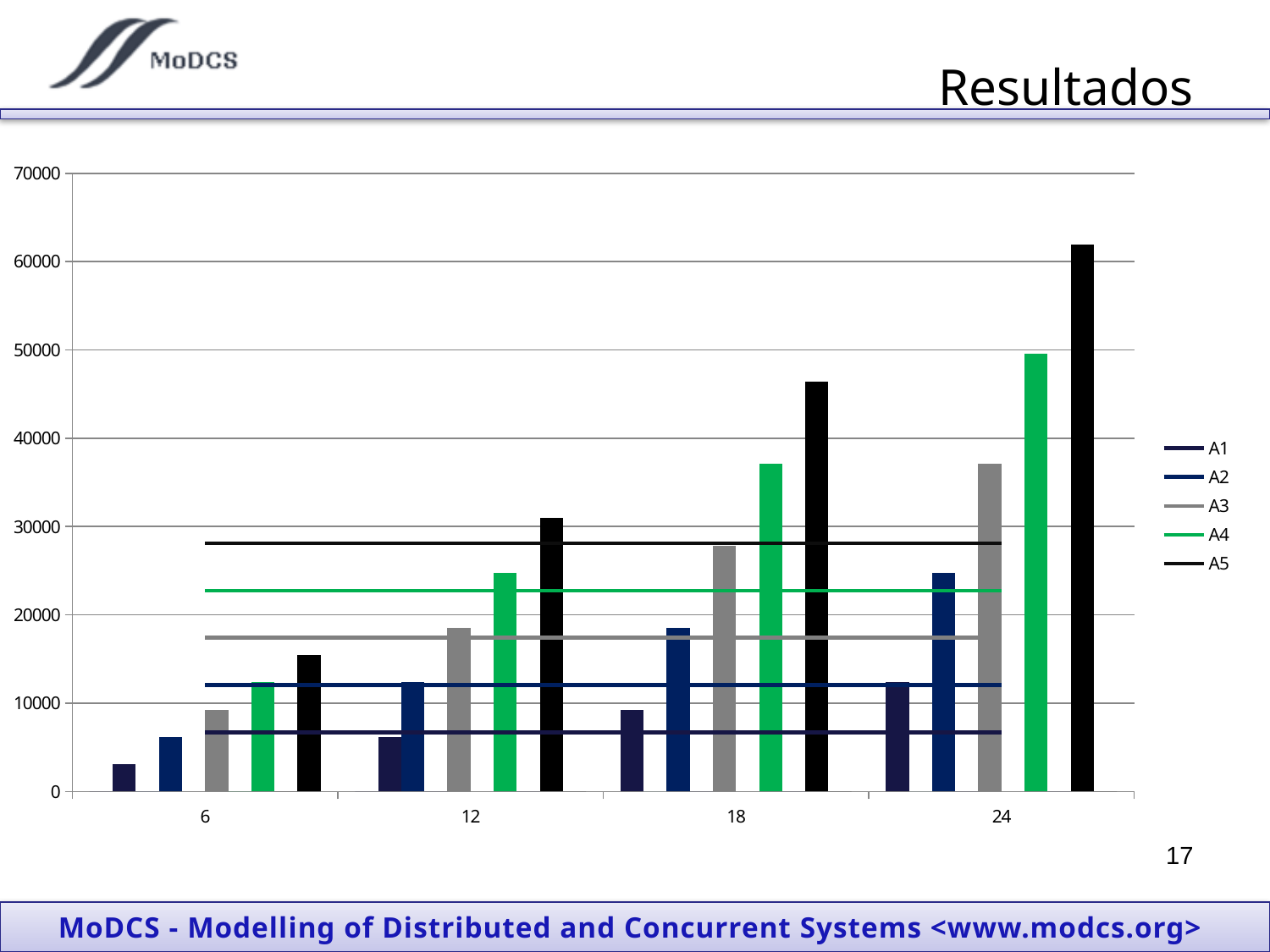
Is the value for A5 at category 24 greater or less than 60000? greater How many categories are shown on the x axis of the chart? 4 What kind of chart is shown on the slide? combination bar and line chart Do the values of series A5 rise or fall as the x axis goes from 6 to 24? rise Which series has the tallest bar in the chart? A5 Which series has the shortest bar at category 6? A1 Is the value for A5 at category 18 greater or less than 40000? greater How many series does the chart's legend list? 5 What colour are the bars for series A4? green At which x-axis category does series A5 reach its highest value? 24 At category 24, which is larger: the value for A5 or the value for A4? A5 Is the value for A1 at category 6 greater or less than 10000? less